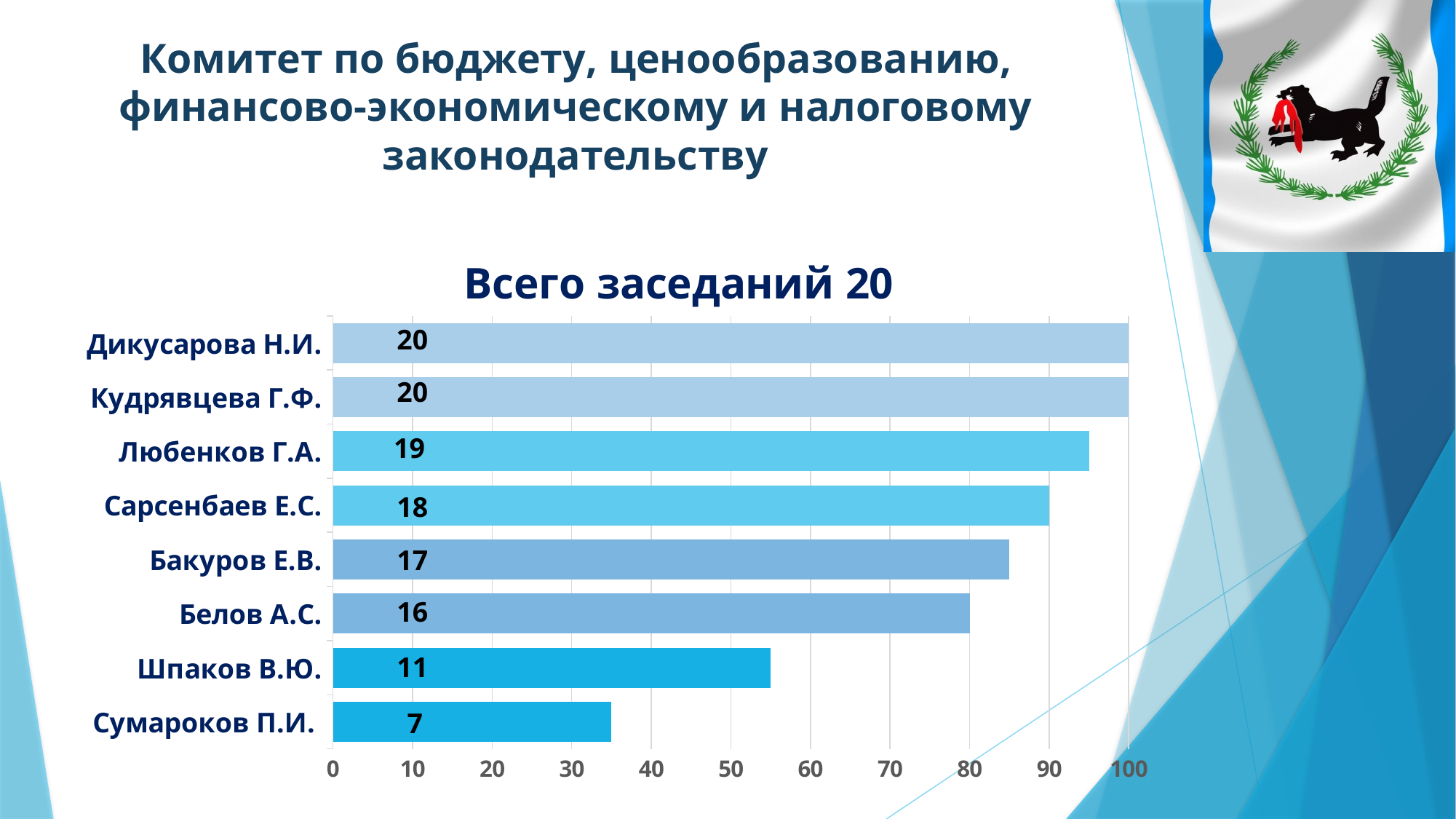
What is the difference between the data labels for Бакуров Е.В. and Шпаков В.Ю.? 6 What is the data label for Сумароков П.И.? 7 What is the data label for Сарсенбаев Е.С.? 18 Which category has the lowest value? Сумароков П.И. Is the bar for Шпаков В.Ю. greater or less than 50 on the axis? greater How many categories are shown in the chart? 8 What is the data label for Любенков Г.А.? 19 Which is larger, the value for Бакуров Е.В. or Белов А.С.? Бакуров Е.В. What is the difference between the data labels for Дикусарова Н.И. and Сумароков П.И.? 13 What is the data label for Шпаков В.Ю.? 11 Is the bar for Сумароков П.И. greater or less than 40 on the axis? less What type of chart is shown? bar chart